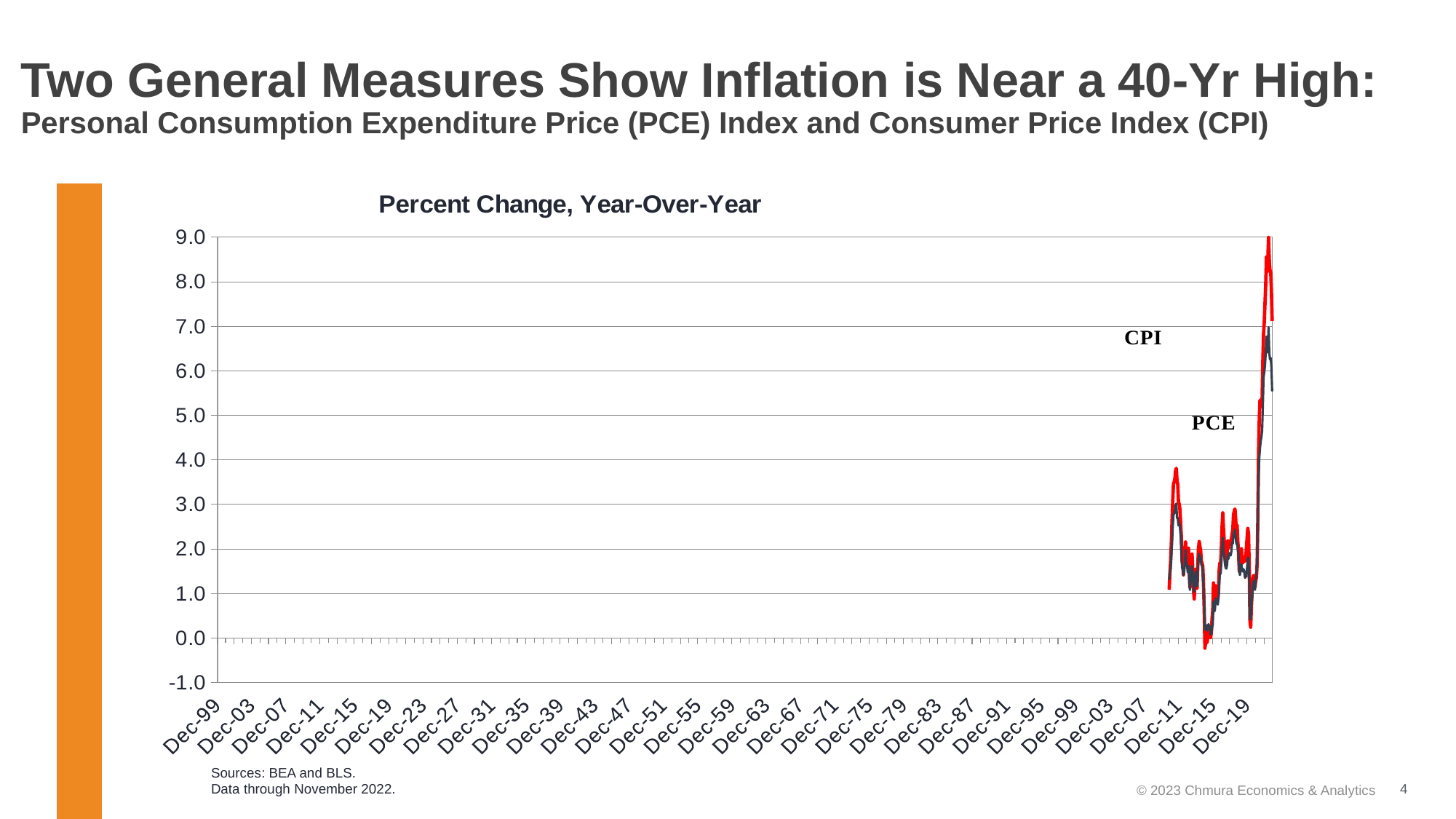
Which series is drawn in red? CPI Does the CPI series rise or fall from Dec-19 to its peak? rise What is the title of the chart? Percent Change, Year-Over-Year Is the peak value of the CPI series greater or less than 8.0? greater What kind of chart is shown on the slide? line chart Is the lowest value of the CPI series greater or less than 1.0? less Which series reaches the higher peak, CPI or PCE? CPI Is the peak value of the PCE series greater or less than 6.0? greater What is the highest value shown on the y-axis? 9.0 How many series are plotted on the chart? 2